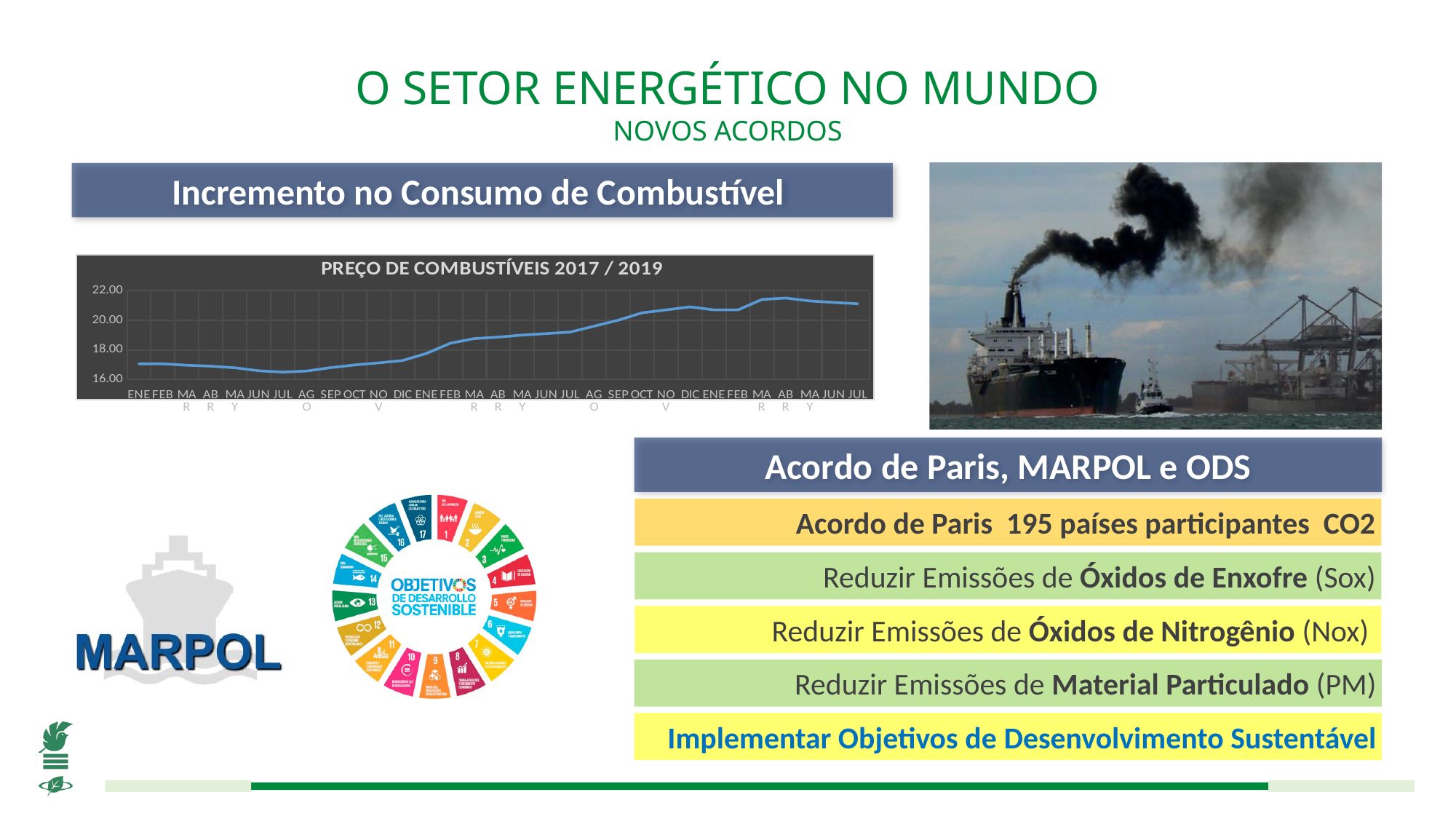
In the 'PREÇO DE COMBUSTÍVEIS 2017 / 2019' chart, which is larger: the value for the first ENE or the value for the last JUL? the last JUL What is the title of the chart on the slide? PREÇO DE COMBUSTÍVEIS 2017 / 2019 In the 'PREÇO DE COMBUSTÍVEIS 2017 / 2019' chart, which is larger: the value for the first ENE or the value for the third ENE? the third ENE What kind of chart is shown under the heading 'Incremento no Consumo de Combustível'? line chart In the 'PREÇO DE COMBUSTÍVEIS 2017 / 2019' chart, do the values generally rise or fall from left to right along the x axis? rise What is the highest tick value shown on the y axis of the 'PREÇO DE COMBUSTÍVEIS 2017 / 2019' chart? 22.00 In the 'PREÇO DE COMBUSTÍVEIS 2017 / 2019' chart, is the value for the first DIC greater or less than 18.00? less In the 'PREÇO DE COMBUSTÍVEIS 2017 / 2019' chart, is the value for the second OCT greater or less than 20.00? greater In the 'PREÇO DE COMBUSTÍVEIS 2017 / 2019' chart, is the value for the first JUN greater or less than 18.00? less How many monthly points are plotted in the 'PREÇO DE COMBUSTÍVEIS 2017 / 2019' chart? 31